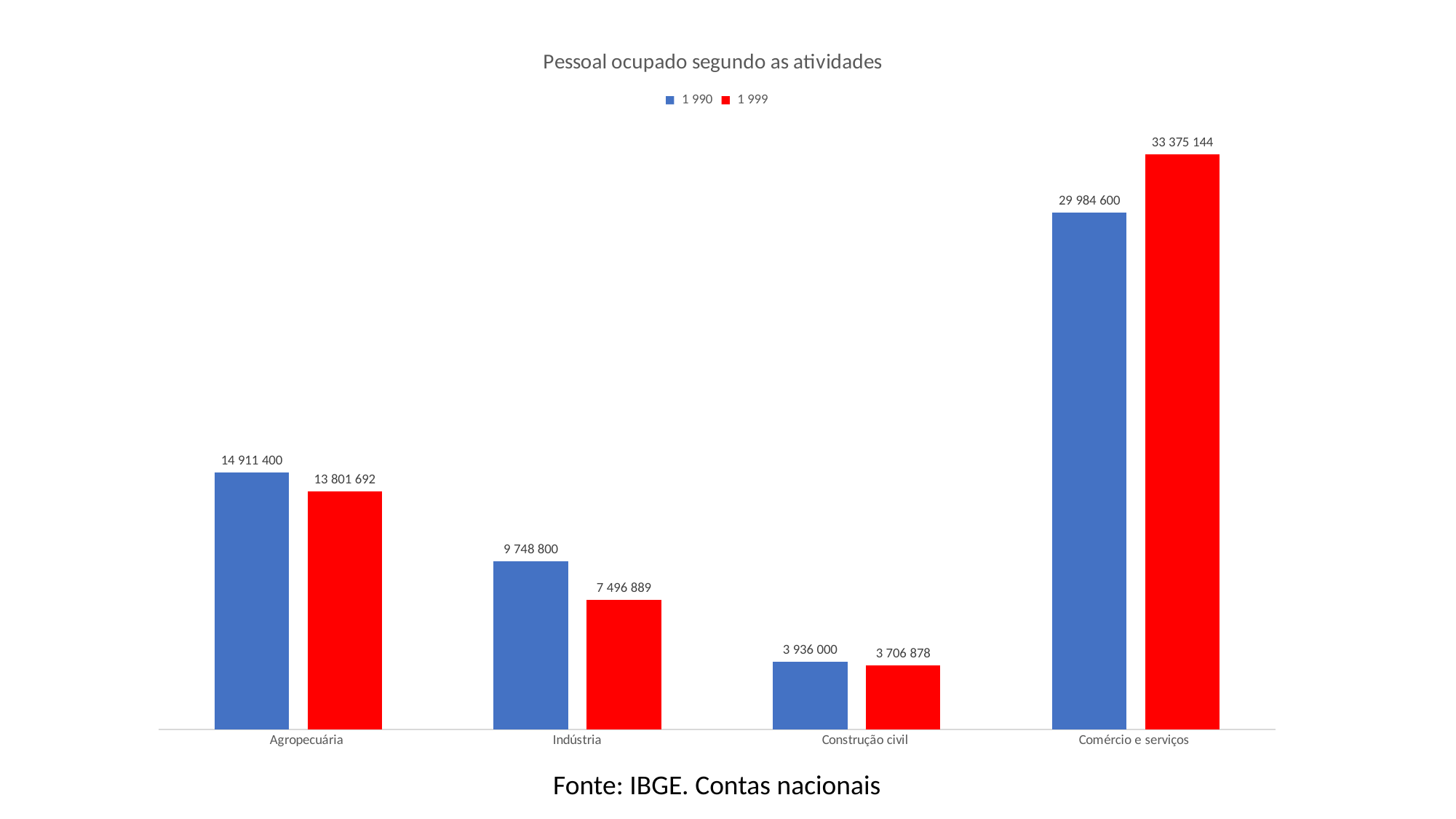
What is the value for Construção civil in the 1 990 series? 3 936 000 What is the difference between the 1 990 and 1 999 values for Agropecuária? 1 109 708 What is the value for Indústria in the 1 999 series? 7 496 889 How many categories are shown on the x axis? 4 What is the value for Agropecuária in the 1 990 series? 14 911 400 Which category has the lowest value in the 1 990 series? Construção civil What is the difference between the 1 999 and 1 990 values for Comércio e serviços? 3 390 544 What is the value for Comércio e serviços in the 1 999 series? 33 375 144 What kind of chart is shown on the slide? Bar chart Which is larger for Indústria: the 1 990 value or the 1 999 value? 1 990 How many series does the legend list? 2 Which category has the highest value in the 1 999 series? Comércio e serviços